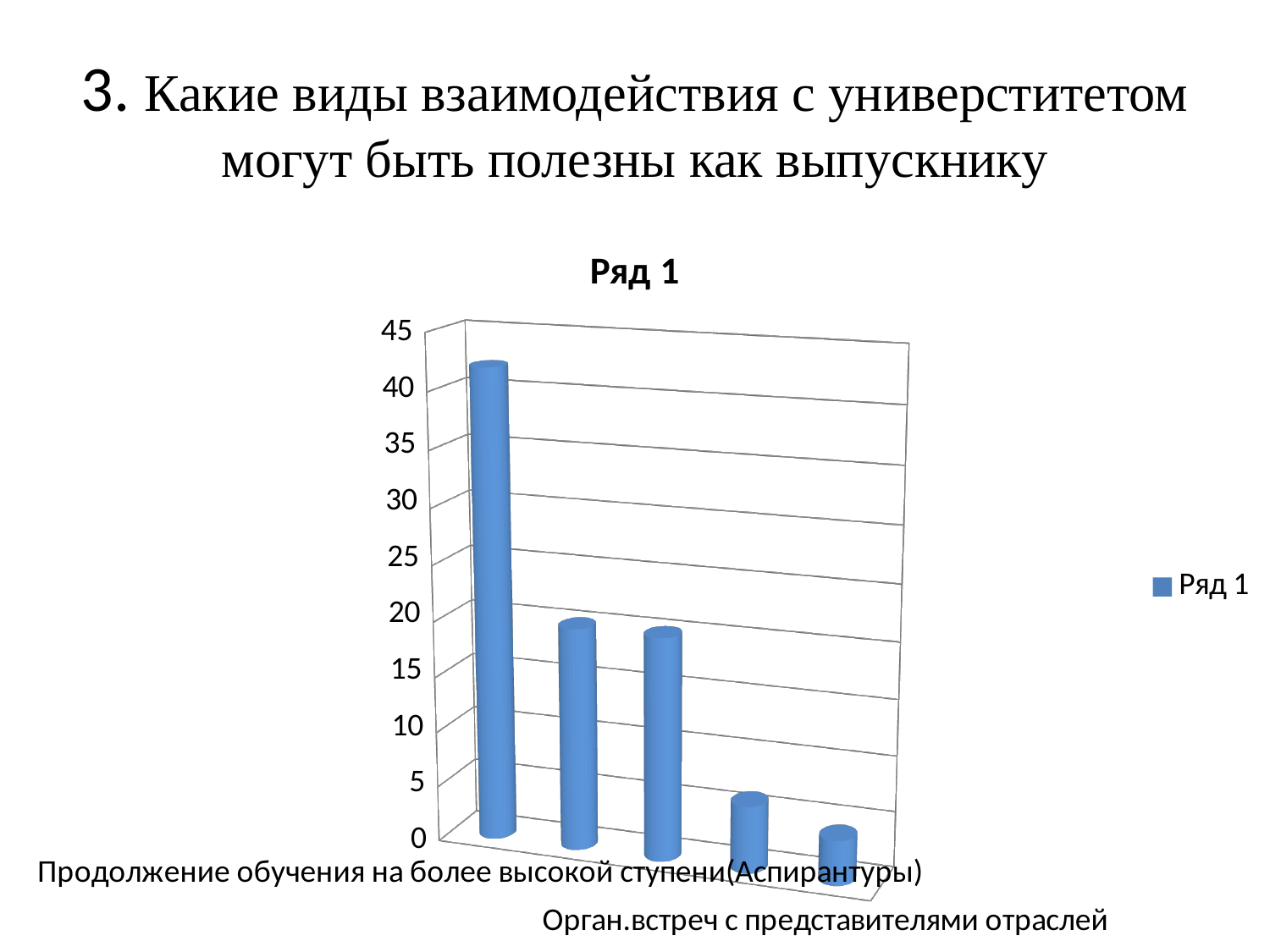
What is the title of the chart? Ряд 1 What is the name of the series shown in the legend? Ряд 1 Is the value of the second bar greater or less than 15? greater What kind of chart is shown on the slide? Bar chart How many bars are plotted in the chart? 5 Which is larger, the first bar or the second bar? The first bar How many series does the legend list? 1 Is the value of the first (leftmost) bar greater or less than 35? greater Which bar is the tallest in the chart? The first (leftmost) bar Do the bar values rise or fall from left to right along the x axis? Fall Which bar is the shortest in the chart? The fifth (rightmost) bar